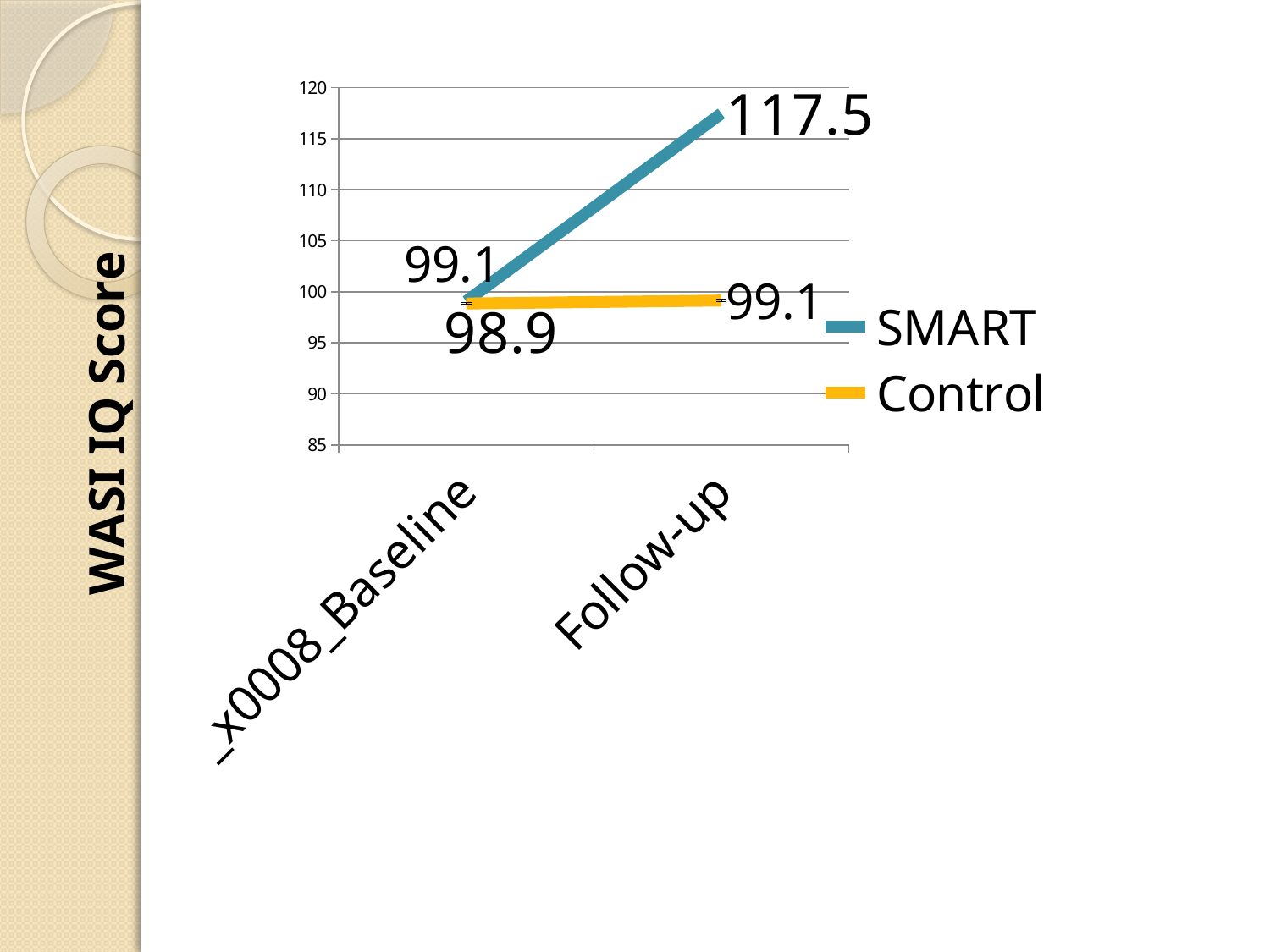
At Follow-up, which series has the higher value, SMART or Control? SMART How many time points are plotted on the x axis? 2 Does the SMART line rise or fall from Baseline to Follow-up? rise What is the Control value at Follow-up? 99.1 What kind of chart is shown on the slide? line chart By how much does the SMART value increase from Baseline to Follow-up? 18.4 Which series is drawn in yellow? Control What is the difference between the SMART and Control values at Follow-up? 18.4 What is the SMART value at Baseline? 99.1 What is the SMART value at Follow-up? 117.5 How many series does the legend list? 2 What is the Control value at Baseline? 98.9